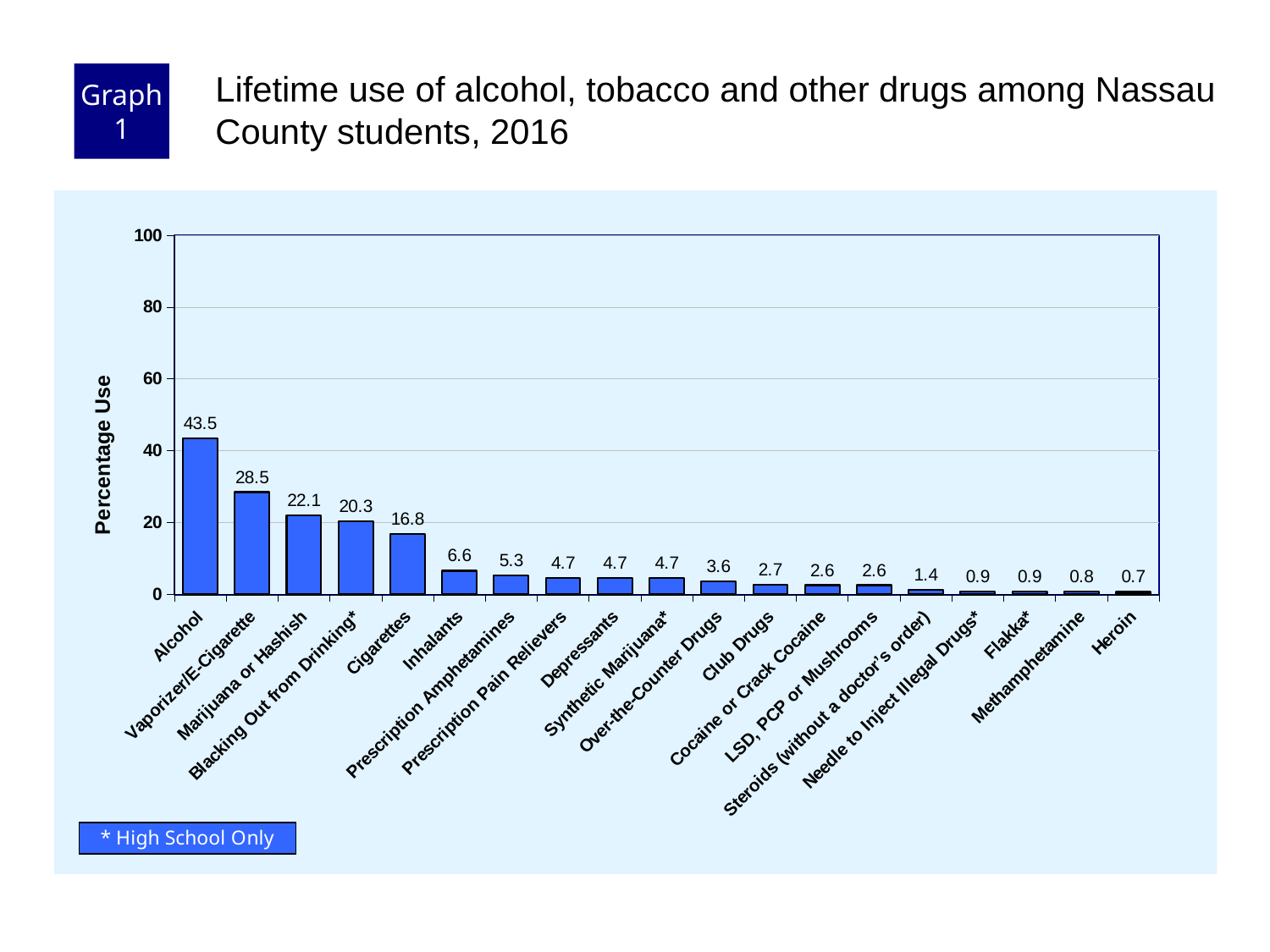
What kind of chart is shown on the slide? Bar chart Is the value for Vaporizer/E-Cigarette greater or less than 20? greater What is the percentage use for Cigarettes? 16.8 What is the percentage use for Heroin? 0.7 What is the percentage use for Inhalants? 6.6 Which category has the lowest percentage use? Heroin How many categories are shown on the chart? 19 What is the label of the y axis? Percentage Use What is the difference in percentage use between Alcohol and Vaporizer/E-Cigarette? 15 Which category has the highest percentage use? Alcohol Which has a higher percentage use, Marijuana or Hashish or Cigarettes? Marijuana or Hashish What is the percentage use for Alcohol? 43.5